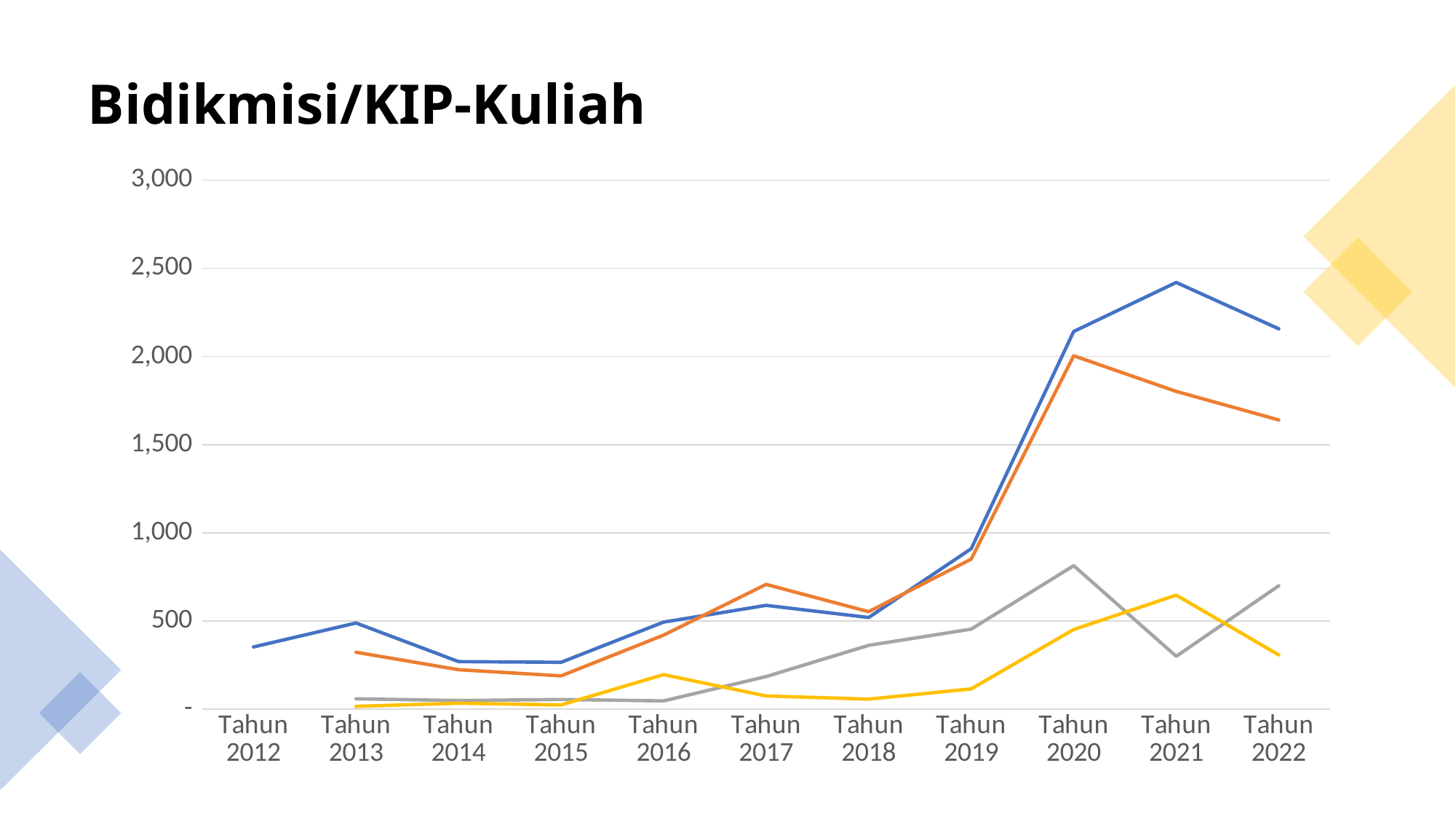
Is the value of the blue line for Tahun 2021 greater or less than 2,000? greater Is the value of the gray line for Tahun 2021 greater or less than 500? less What is the title of the chart? Bidikmisi/KIP-Kuliah In which year does the gray line reach its highest value? Tahun 2020 In which year does the blue line reach its highest value? Tahun 2021 What kind of chart is shown on the slide? line chart Does the blue line rise or fall between Tahun 2019 and Tahun 2020? rise How many lines are plotted on the chart? 4 For Tahun 2021, which line has the larger value, the blue line or the orange line? blue line In which year does the orange line reach its highest value? Tahun 2020 Is the value of the orange line for Tahun 2022 greater or less than 1,500? greater How many years are shown along the x axis? 11